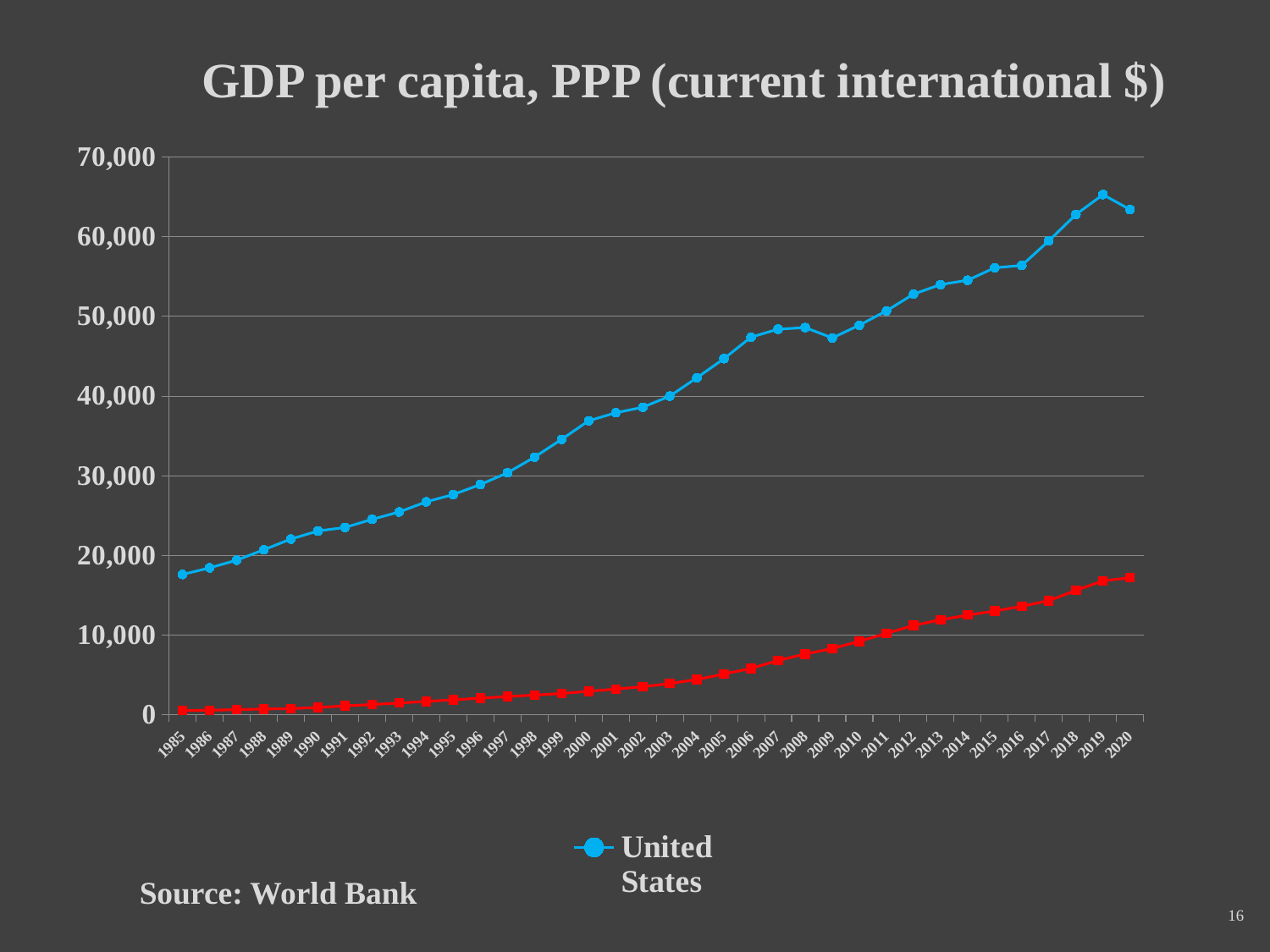
Which year has the larger United States value, 2019 or 2020? 2019 Is the United States value for 2019 greater or less than 60,000? greater What is the title of the chart? GDP per capita, PPP (current international $) What type of chart is shown on the slide? line chart In which year is the United States value lowest? 1985 How many years are plotted along the x axis? 36 Does the United States value generally rise or fall from 1985 to 2019? rise In which year is the United States value highest? 2019 Is the United States value for 1985 greater or less than 20,000? less How many series does the legend list? 1 Is the United States value for 2009 greater or less than 50,000? less